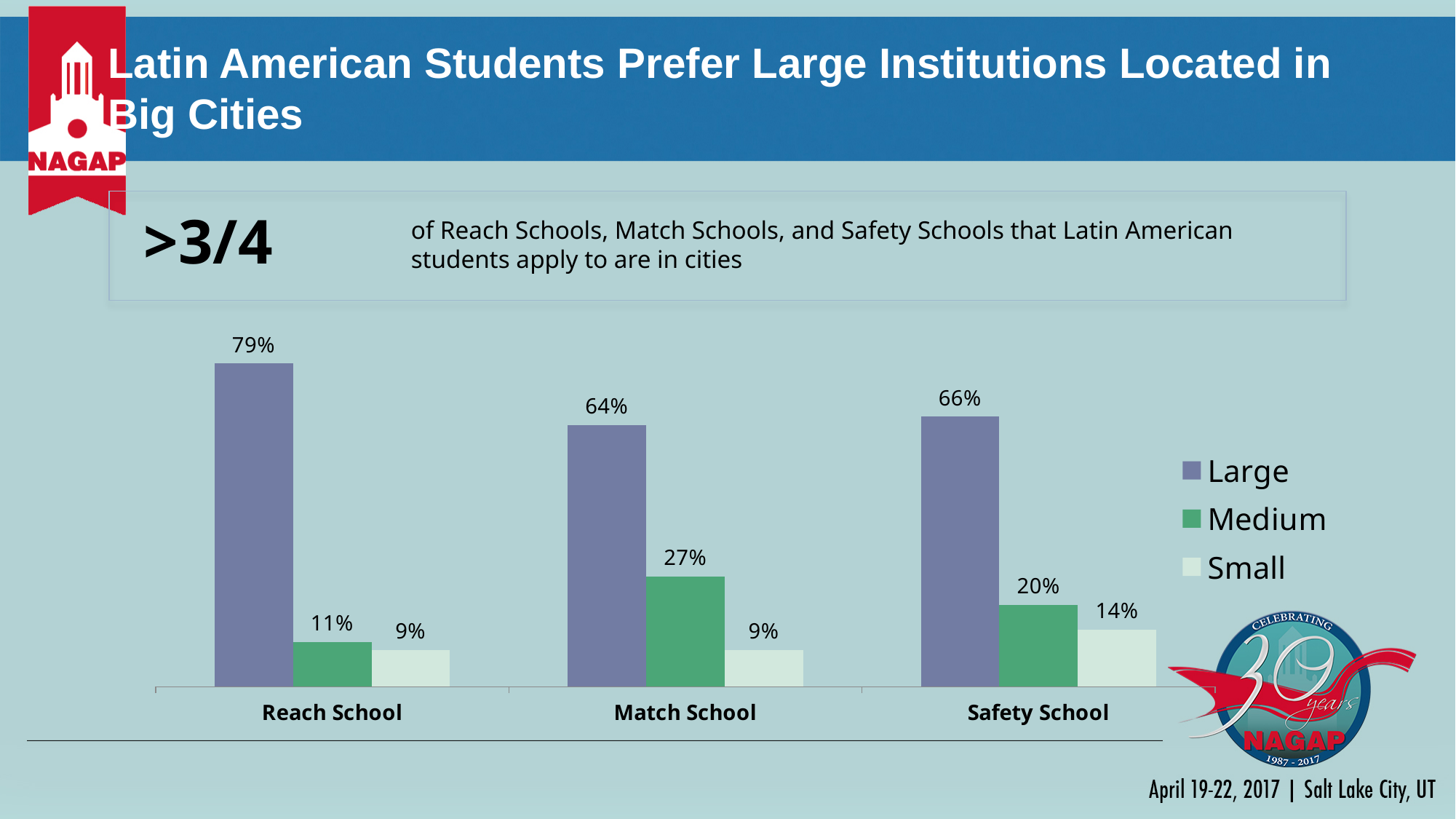
What is the difference between the Large values for Reach School and Match School? 15% What is the value for Small at Safety School? 14% How many series does the legend list? 3 Do the Medium values rise or fall from Match School to Safety School? Fall Which school category has the lowest value for Medium? Reach School Which series is shown in green in the legend? Medium How many school categories are shown on the x axis? 3 Which is larger: the Medium value for Safety School or the Medium value for Match School? Match School What is the value for Medium at Match School? 27% What kind of chart is shown on the slide? Bar chart Which school category has the highest value for Large? Reach School What is the value for Large at Reach School? 79%